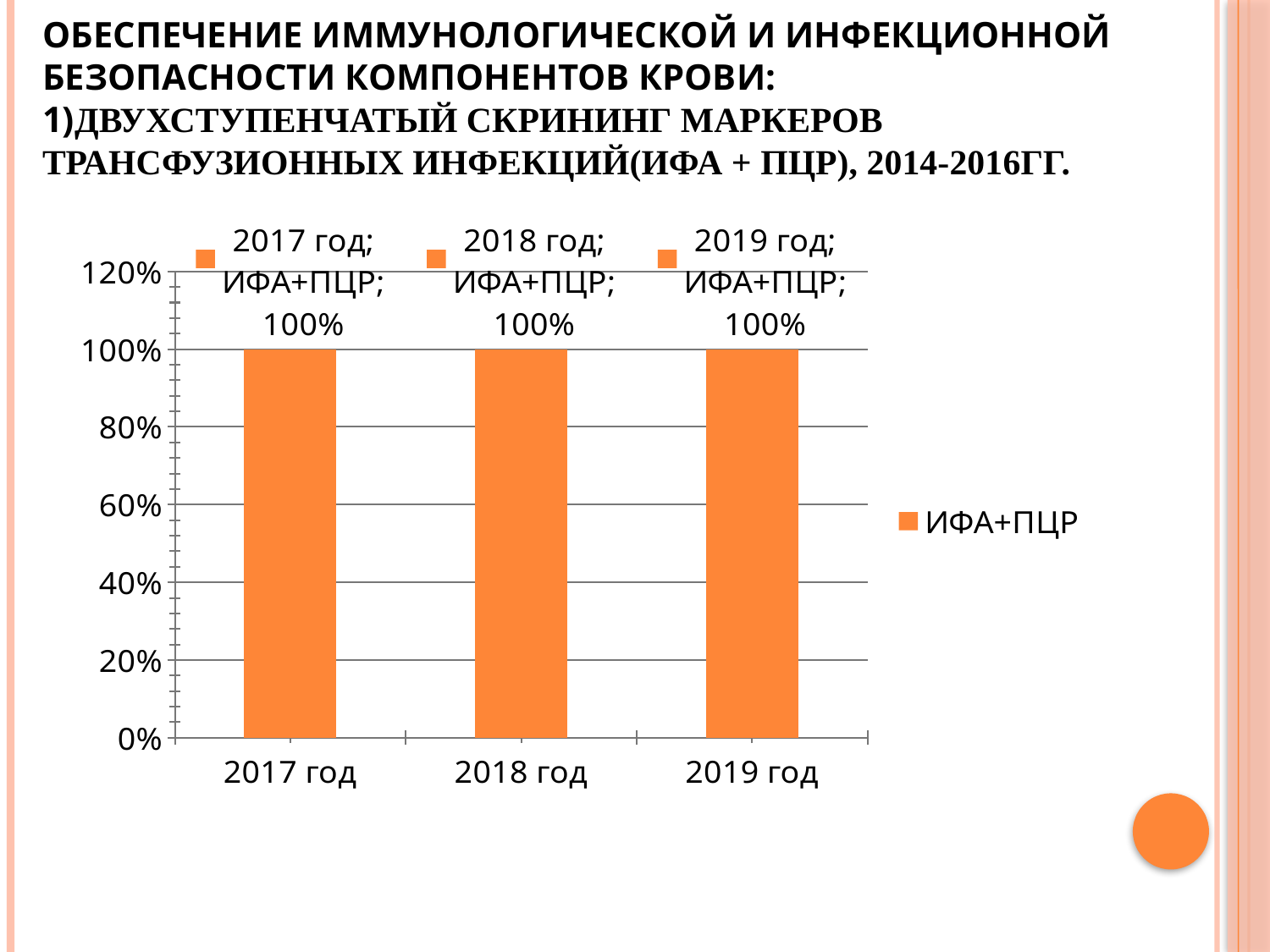
What is the name of the series shown in the legend? ИФА+ПЦР What colour are the bars in the chart? orange What is the value for 2018 год? 100% What is the difference between the values for 2017 год and 2019 год? 0% What is the value for 2019 год? 100% What is the value for 2017 год? 100% How many categories are shown on the x axis? 3 Is the value for 2018 год greater or less than 80%? greater What kind of chart is shown on the slide? bar chart How many series does the legend list? 1 Do the values rise, fall or stay the same from 2017 год to 2019 год? stay the same